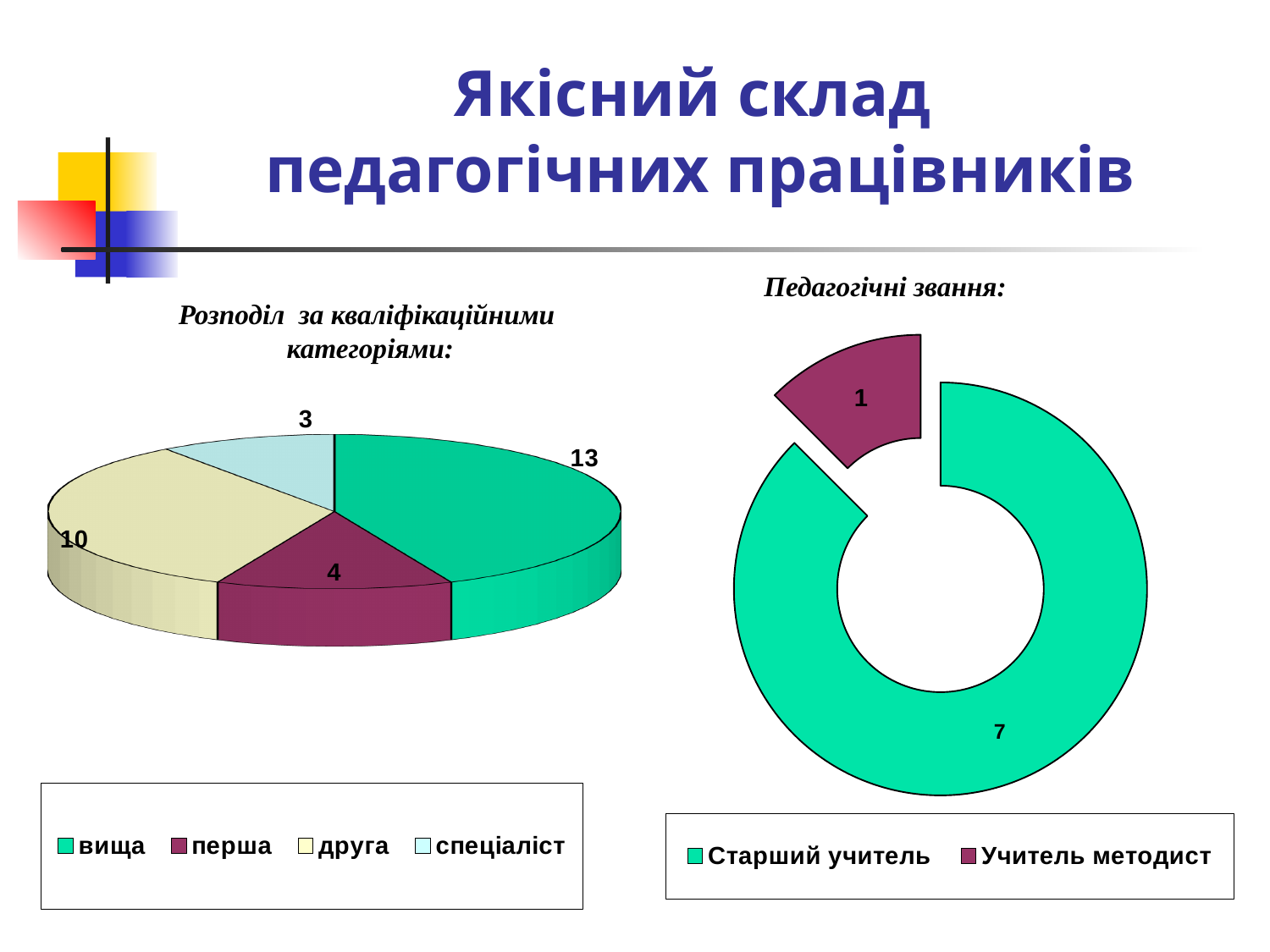
In the chart 'Розподіл за кваліфікаційними категоріями', what is the difference between 'вища' and 'перша'? 9 In the chart 'Педагогічні звання', which is larger, 'Старший учитель' or 'Учитель методист'? Старший учитель In the chart 'Розподіл за кваліфікаційними категоріями', what is the value for 'друга'? 10 What kind of chart is 'Розподіл за кваліфікаційними категоріями'? pie chart In the chart 'Педагогічні звання', what share of the total does 'Учитель методист' represent? 12.5% In the chart 'Розподіл за кваліфікаційними категоріями', what is the value for 'вища'? 13 In the chart 'Розподіл за кваліфікаційними категоріями', how many categories are shown? 4 In the chart 'Педагогічні звання', what is the value for 'Старший учитель'? 7 How many entries does the legend of the chart 'Педагогічні звання' list? 2 In the chart 'Розподіл за кваліфікаційними категоріями', which category has the smallest value? спеціаліст In the chart 'Педагогічні звання', what is the value for 'Учитель методист'? 1 In the chart 'Розподіл за кваліфікаційними категоріями', which category has the largest value? вища